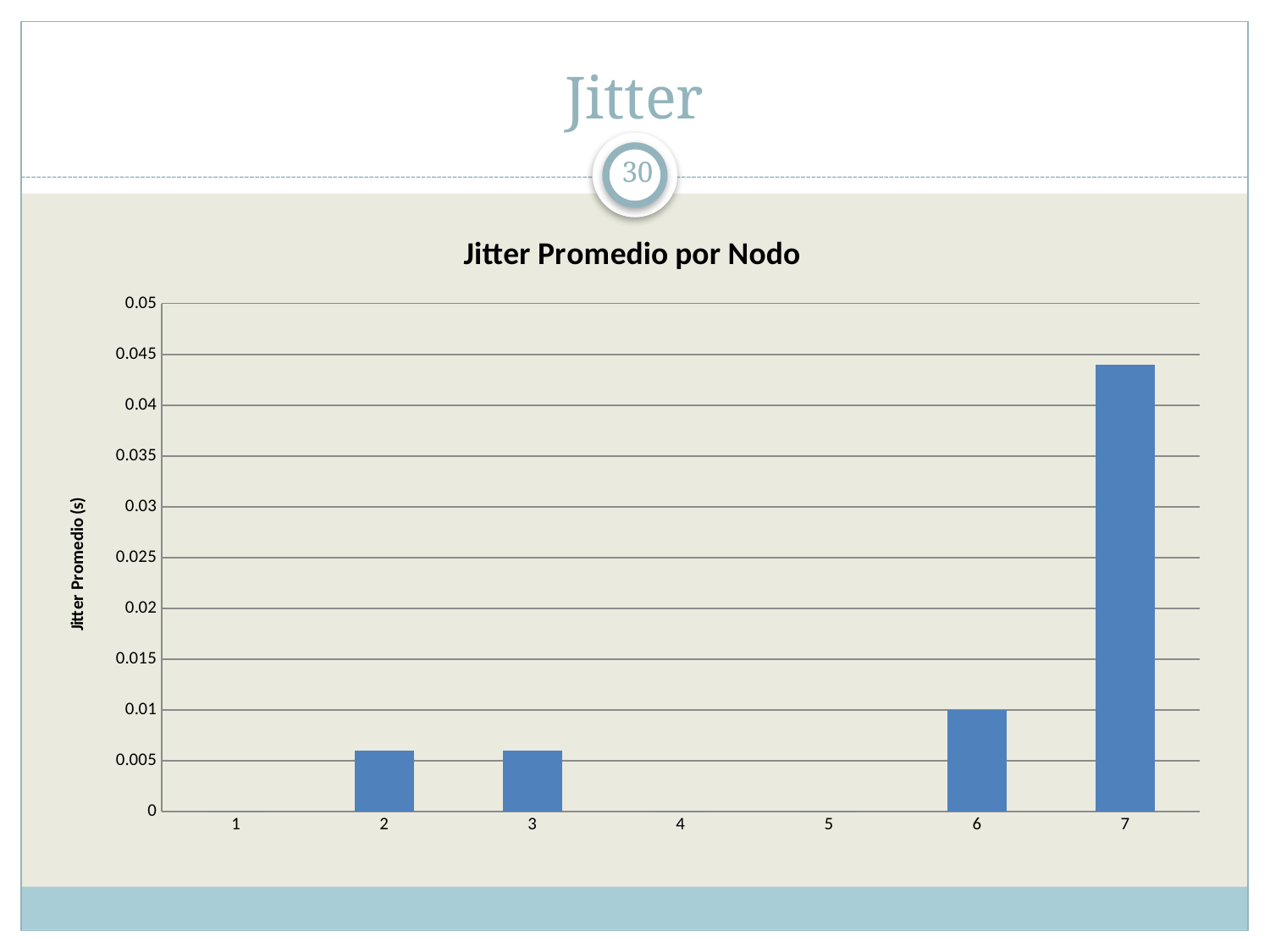
How many nodes are shown on the x axis? 7 What is the average jitter value for node 6? 0.01 Which node has the highest average jitter? 7 Is the value for node 7 greater or less than 0.04? greater Which has a larger average jitter, node 7 or node 6? node 7 Is the value for node 2 greater or less than 0.005? greater How many nodes show no visible bar (a value of 0)? 3 What is the title of the chart? Jitter Promedio por Nodo What kind of chart is shown on the slide? bar chart Which has a larger average jitter, node 6 or node 2? node 6 Is the value for node 3 greater or less than 0.01? less What is the label of the vertical axis? Jitter Promedio (s)